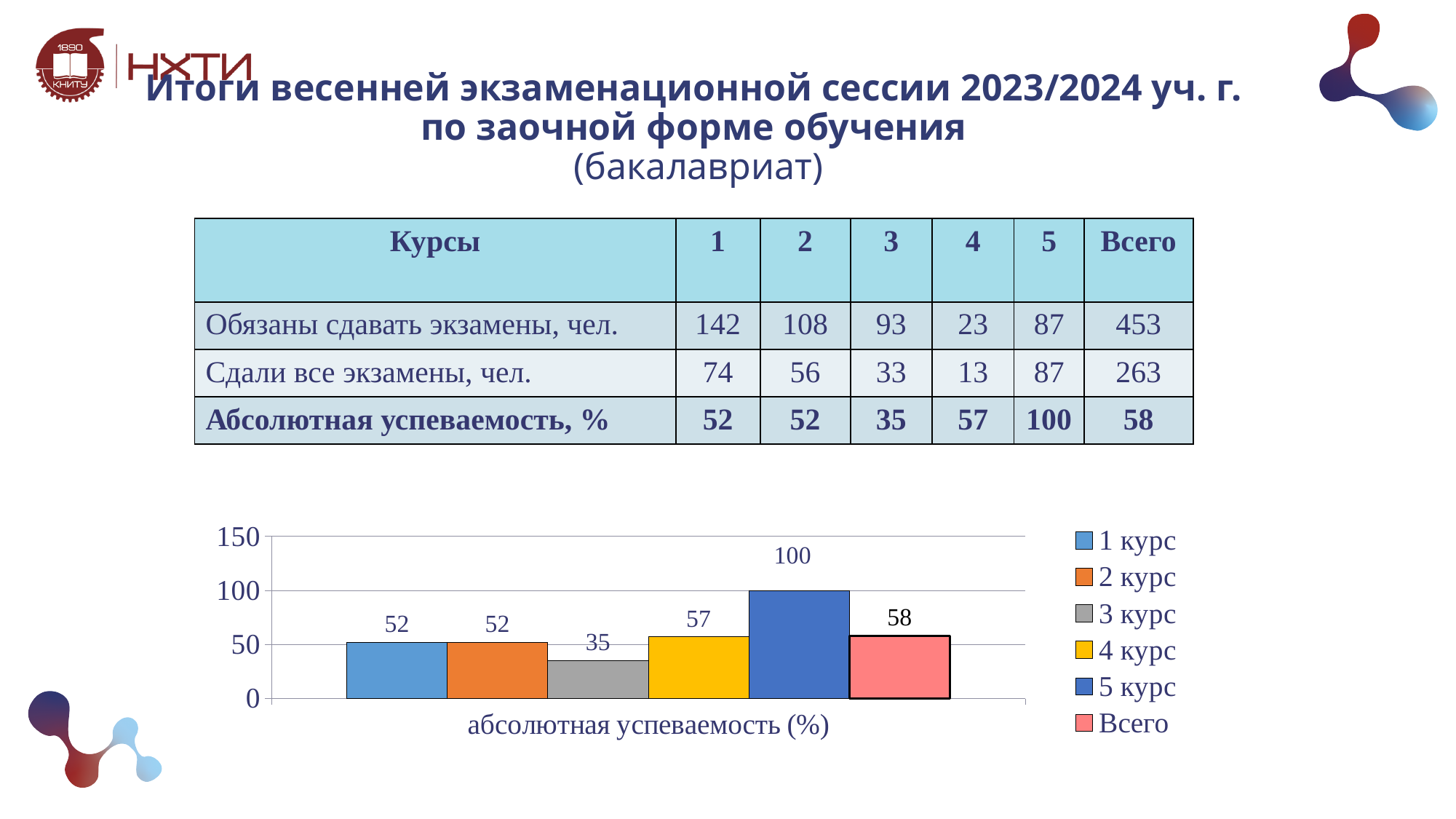
Which is larger in the chart, the value for 4 курс or the value for 2 курс? 4 курс How many series does the chart legend list? 6 What is the value for 5 курс in the chart? 100 What is the x-axis label of the chart? абсолютная успеваемость (%) What is the difference between the values for 4 курс and 1 курс in the chart? 5 Is the value for 5 курс in the chart greater or less than 50? greater What is the difference between the values for 5 курс and 3 курс in the chart? 65 Which series has the lowest value in the chart? 3 курс Which series has the highest value in the chart? 5 курс What is the value for Всего in the chart? 58 What is the value for 3 курс in the chart? 35 What kind of chart is shown on the slide? bar chart